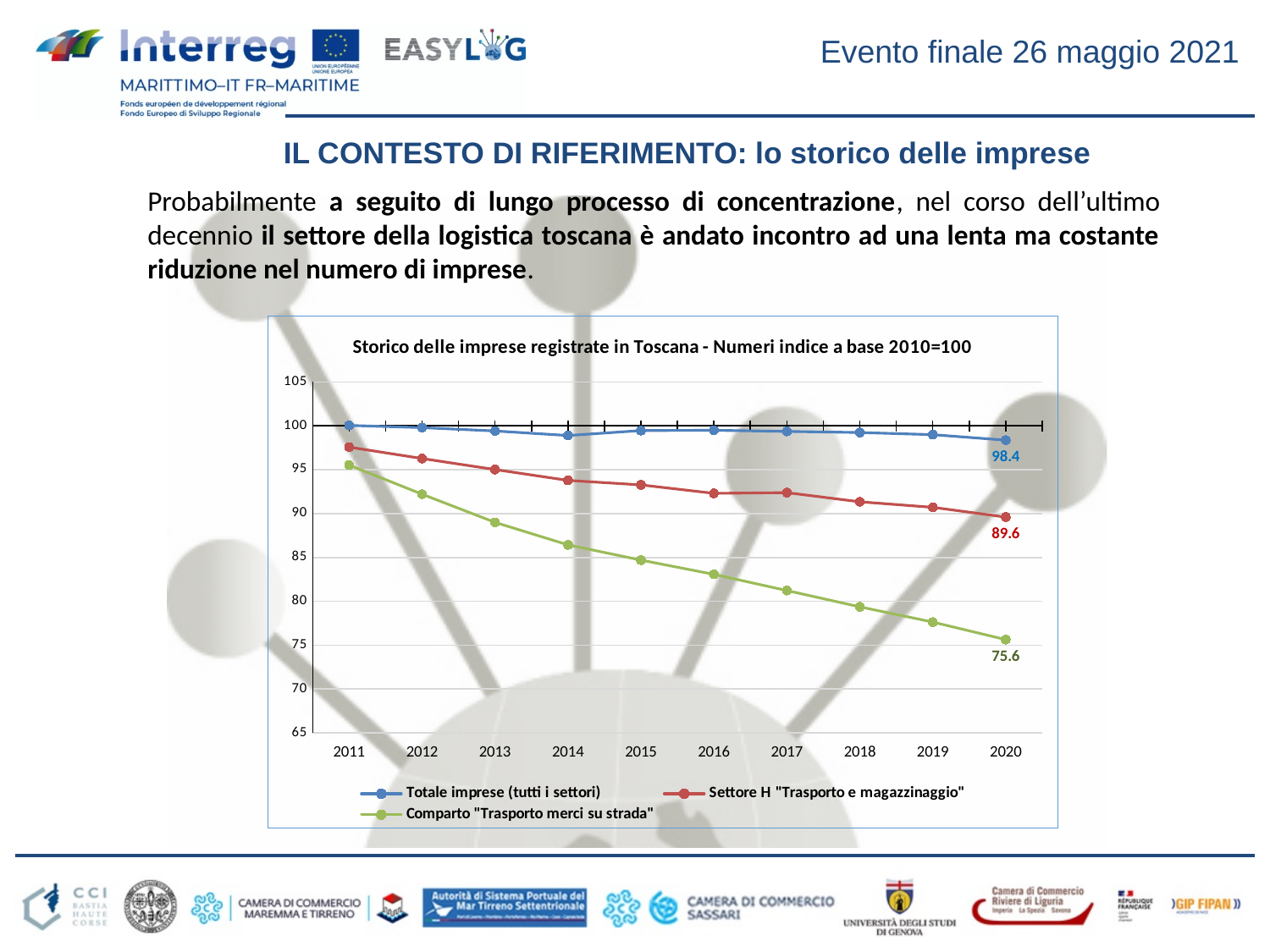
What is the value of "Totale imprese (tutti i settori)" in 2020? 98.4 How many years are shown on the x axis? 10 What is the difference between the 2020 values of "Totale imprese (tutti i settori)" and "Comparto "Trasporto merci su strada""? 22.8 In 2020, which is larger: "Settore H "Trasporto e magazzinaggio"" or "Comparto "Trasporto merci su strada""? Settore H "Trasporto e magazzinaggio" What is the value of "Settore H "Trasporto e magazzinaggio"" in 2020? 89.6 What is the difference between the 2020 values of "Settore H "Trasporto e magazzinaggio"" and "Comparto "Trasporto merci su strada""? 14.0 Which series has the lowest value in 2020? Comparto "Trasporto merci su strada" Is the value for "Comparto "Trasporto merci su strada"" in 2016 greater or less than 85? less What kind of chart is shown on the slide? Line chart What is the value of "Comparto "Trasporto merci su strada"" in 2020? 75.6 Which series has the highest value in 2020? Totale imprese (tutti i settori) How many series does the legend list? 3